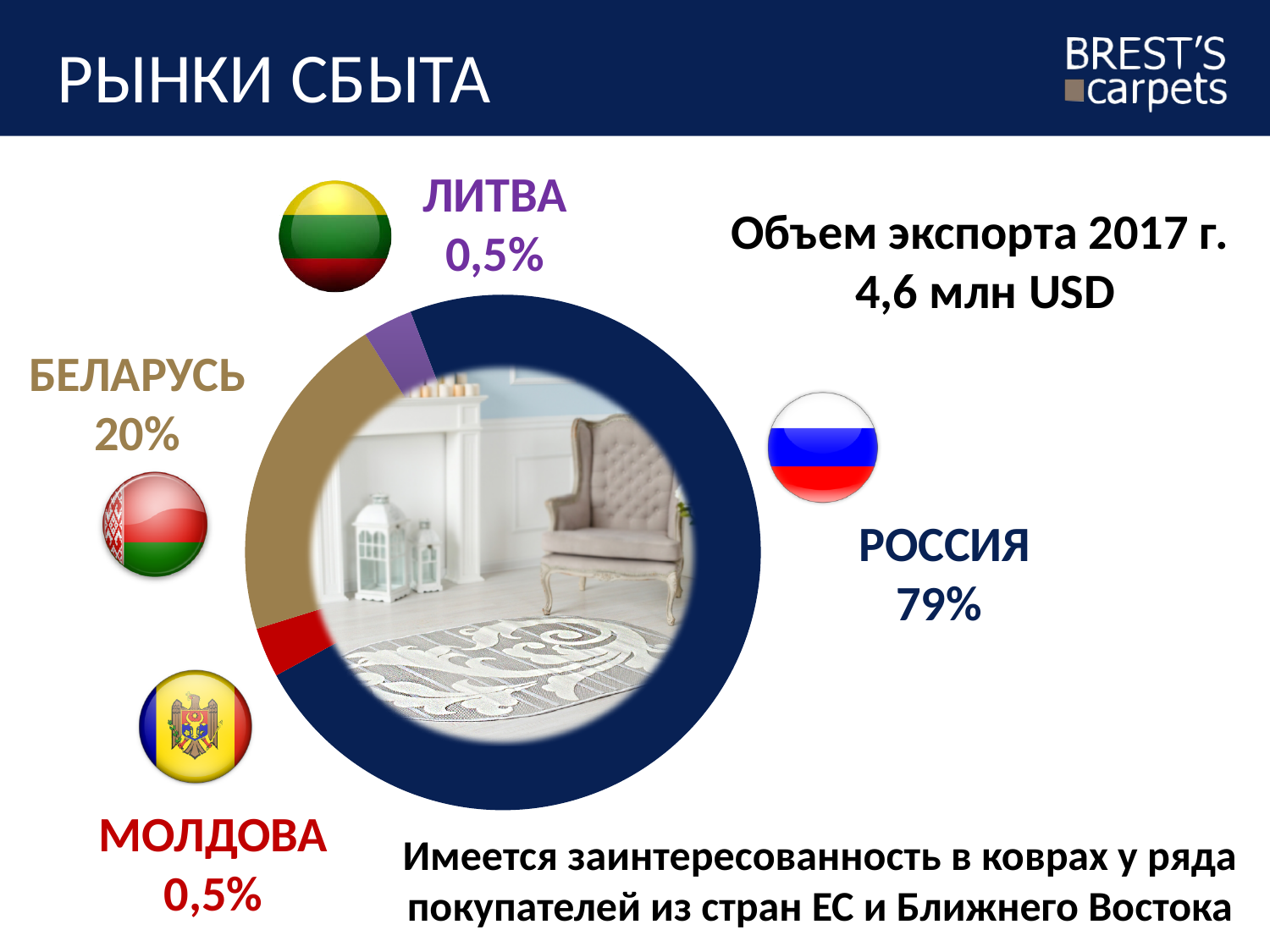
Which country has the largest share in the chart? Россия What share of sales markets does Россия account for? 79% How many countries are shown in the chart? 4 What colour is the segment for Россия in the chart? dark blue What kind of chart is shown on the slide? doughnut chart What share of sales markets does Молдова account for? 0,5% What share of sales markets does Литва account for? 0,5% Which has a larger share, Беларусь or Литва? Беларусь What is the difference in percentage points between the shares of Россия and Беларусь? 59 Which two countries share the smallest value in the chart? Литва and Молдова What is the title of the slide containing the chart? РЫНКИ СБЫТА What share of sales markets does Беларусь account for? 20%